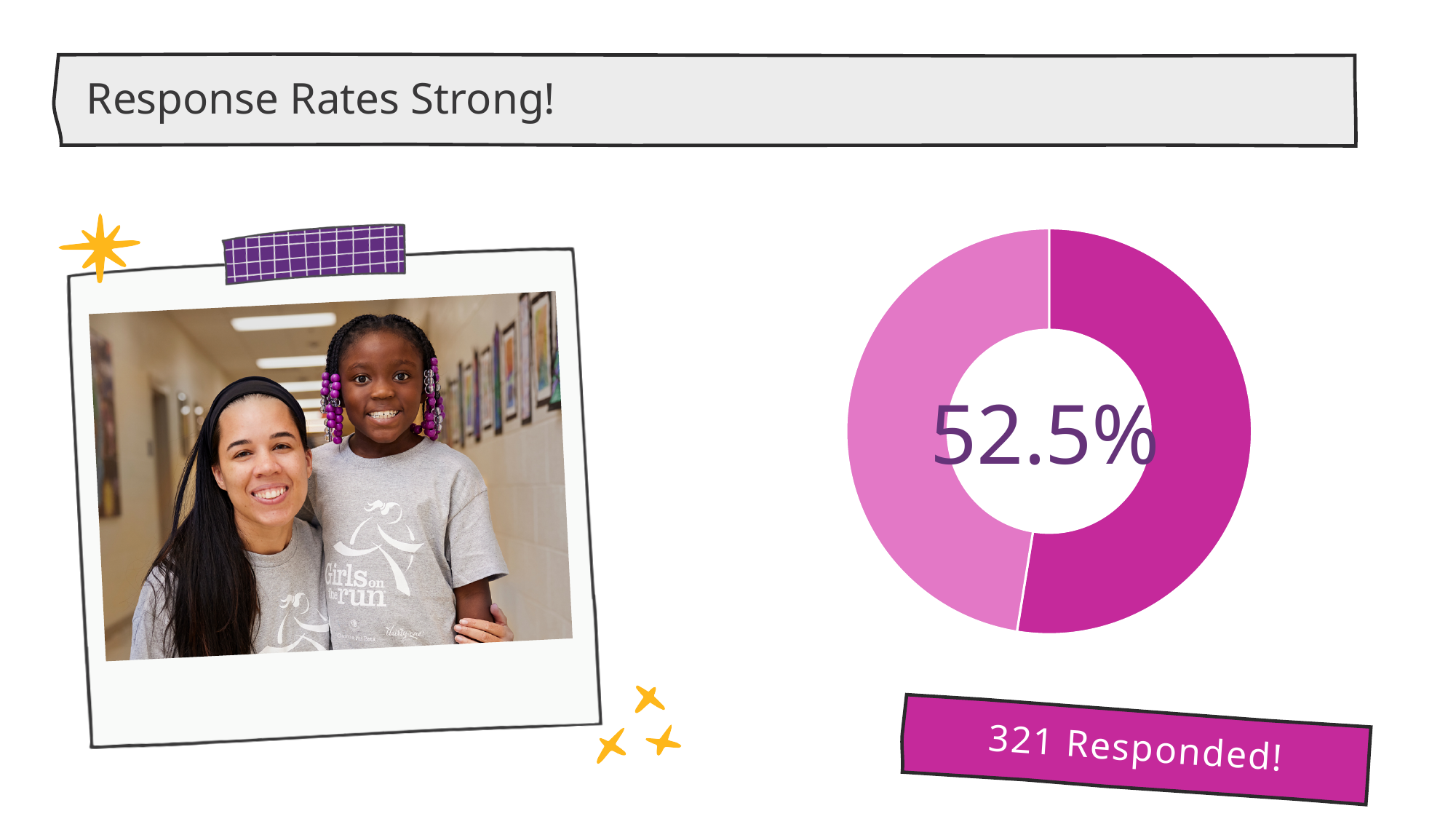
How many slices does the donut chart have? 2 What is the title of the slide containing the donut chart? Response Rates Strong! What kind of chart is shown on the slide? Donut (pie) chart How many people responded, according to the label below the donut chart? 321 What percentage is printed in the center of the donut chart? 52.5%